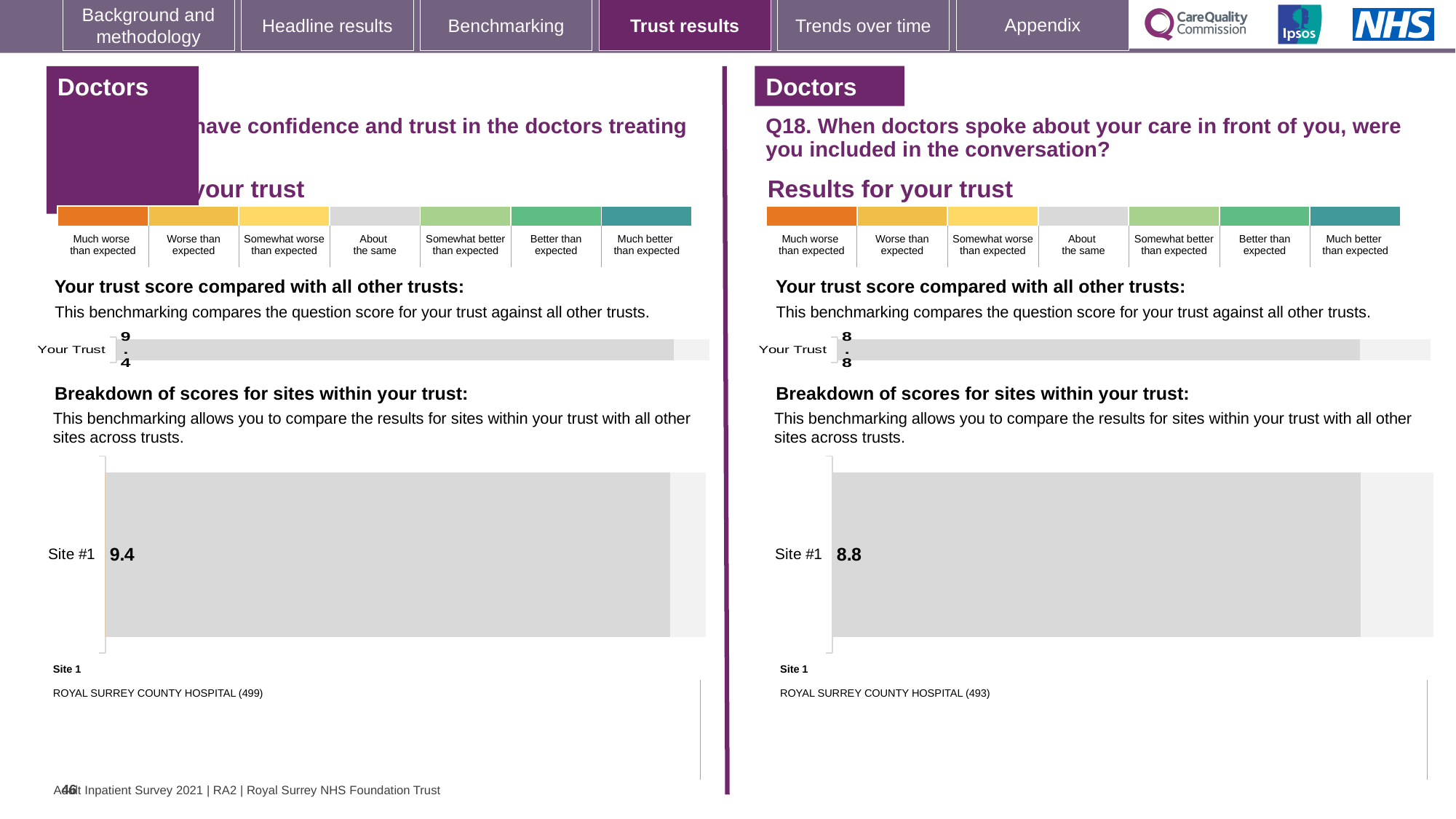
On the right panel (Q18), what is the score shown for Your Trust in the 'Your trust score compared with all other trusts' chart? 8.8 Which is larger: the Your Trust score on the left panel or the Your Trust score on the right panel (Q18)? Left panel What kind of chart is used to show the Site #1 score on the right panel (Q18)? Bar chart How many sites are shown in the 'Breakdown of scores for sites within your trust' chart on the right panel (Q18)? 1 On the left panel, what is the score shown for Your Trust in the 'Your trust score compared with all other trusts' chart? 9.4 How many sites are shown in the 'Breakdown of scores for sites within your trust' chart on the left panel? 1 On the right panel (Q18), what is the score shown for Site #1 in the 'Breakdown of scores for sites within your trust' chart? 8.8 On the left panel, what is the score shown for Site #1 in the 'Breakdown of scores for sites within your trust' chart? 9.4 Which site is listed as Site 1 on the right panel (Q18)? ROYAL SURREY COUNTY HOSPITAL (493) How many benchmark categories are shown in the colour scale above the 'Your trust score compared with all other trusts' chart on the right panel (Q18)? 7 What is the difference between the Site #1 score on the left panel and the Site #1 score on the right panel (Q18)? 0.6